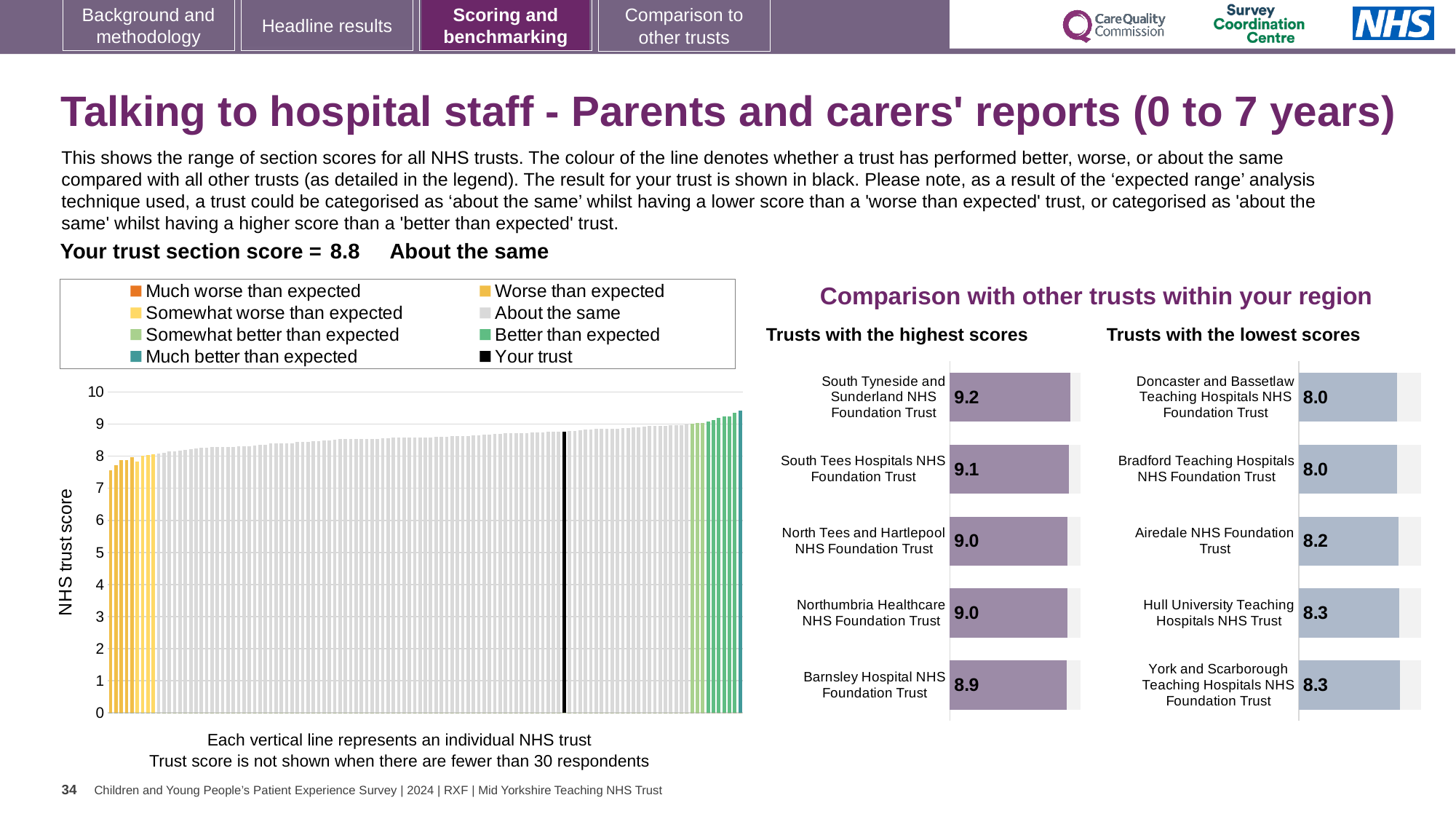
In the main NHS trust score chart on the left, is the value for your trust greater or less than 8? greater In the 'Trusts with the highest scores' chart, what is the difference between the scores of South Tyneside and Sunderland NHS Foundation Trust and Barnsley Hospital NHS Foundation Trust? 0.3 In the 'Trusts with the lowest scores' chart, what is the difference between the scores of Hull University Teaching Hospitals NHS Trust and Doncaster and Bassetlaw Teaching Hospitals NHS Foundation Trust? 0.3 In the 'Trusts with the highest scores' chart, which has the larger score: South Tees Hospitals NHS Foundation Trust or North Tees and Hartlepool NHS Foundation Trust? South Tees Hospitals NHS Foundation Trust How many trusts are shown in the 'Trusts with the lowest scores' chart? 5 In the main NHS trust score chart on the left, what is the section score for your trust? 8.8 In the main NHS trust score chart on the left, do the trust scores rise or fall from left to right? rise In the 'Trusts with the lowest scores' chart, what is the score for Airedale NHS Foundation Trust? 8.2 In the 'Trusts with the highest scores' chart, what is the score for South Tyneside and Sunderland NHS Foundation Trust? 9.2 In the 'Trusts with the highest scores' chart, which trust has the highest score? South Tyneside and Sunderland NHS Foundation Trust In the 'Trusts with the highest scores' chart, which trust has the lowest score? Barnsley Hospital NHS Foundation Trust How many entries does the legend of the main NHS trust score chart list? 8